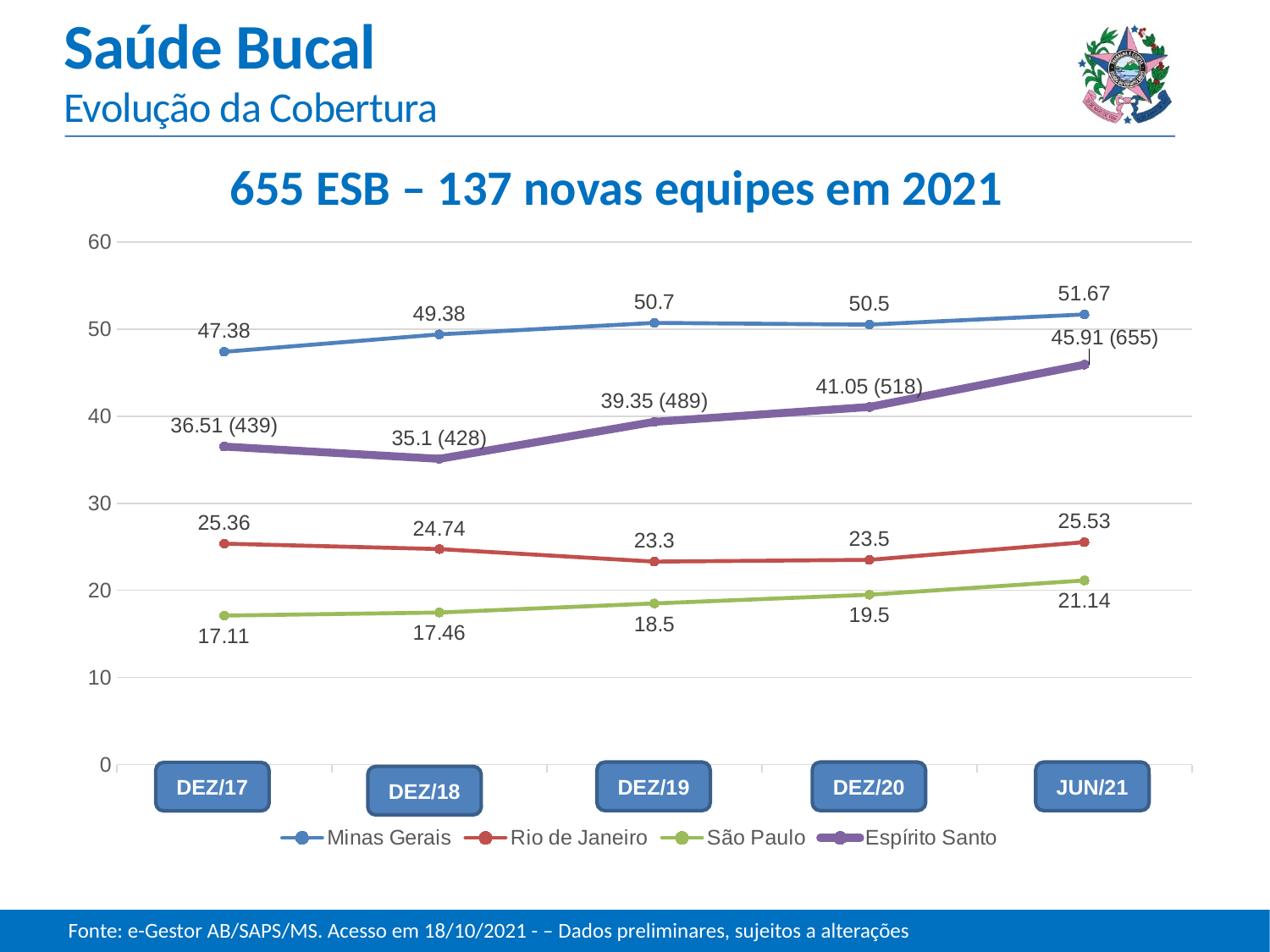
What is the value for Espírito Santo at DEZ/18? 35.1 (428) Which series has the highest value at JUN/21? Minas Gerais What type of chart is shown on the slide? line chart Does the São Paulo series rise or fall from DEZ/17 to JUN/21? rise What is the value for Minas Gerais at JUN/21? 51.67 What is the difference between the Minas Gerais value at JUN/21 (51.67) and at DEZ/17 (47.38)? 4.29 Which series has the lowest value at DEZ/17? São Paulo How many series does the legend list? 4 How many time points are plotted along the x axis? 5 What is the value for Rio de Janeiro at DEZ/20? 23.5 What is the value for São Paulo at DEZ/19? 18.5 Which is larger at DEZ/19: the value for Rio de Janeiro or the value for São Paulo? Rio de Janeiro